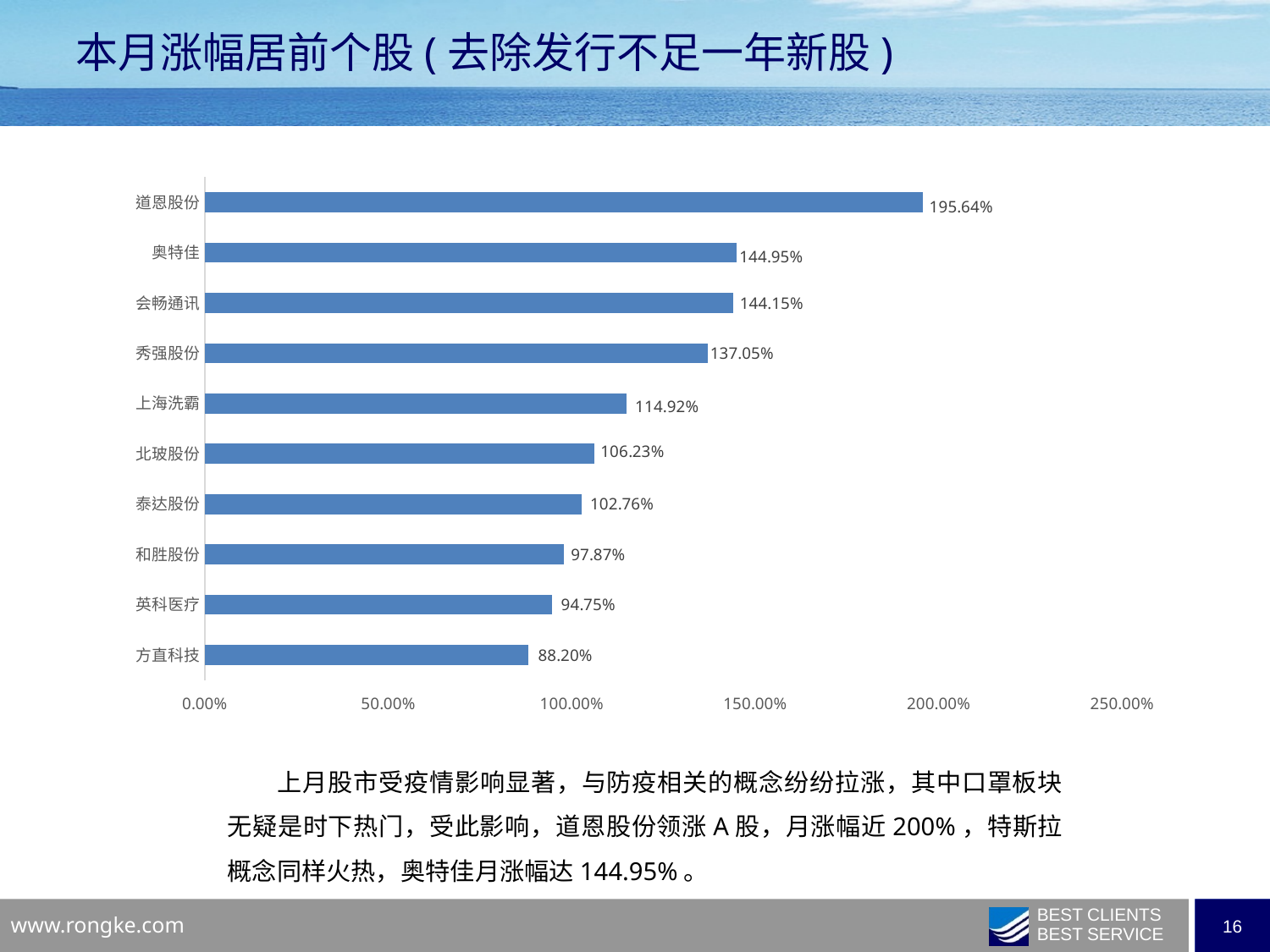
How many stocks are shown in the chart? 10 What is the highest value shown on the x axis? 250.00% What is the value for 上海洗霸? 114.92% What kind of chart is shown on the slide? bar chart Which stock has the lowest value? 方直科技 What is the value for 道恩股份? 195.64% What is the difference between the values for 和胜股份 and 英科医疗? 3.12% Which stock has the highest value? 道恩股份 Is the value for 泰达股份 greater or less than 100.00%? greater Which is larger, the value for 秀强股份 or the value for 北玻股份? 秀强股份 What is the difference between the values for 道恩股份 and 奥特佳? 50.69% What is the value for 方直科技? 88.20%